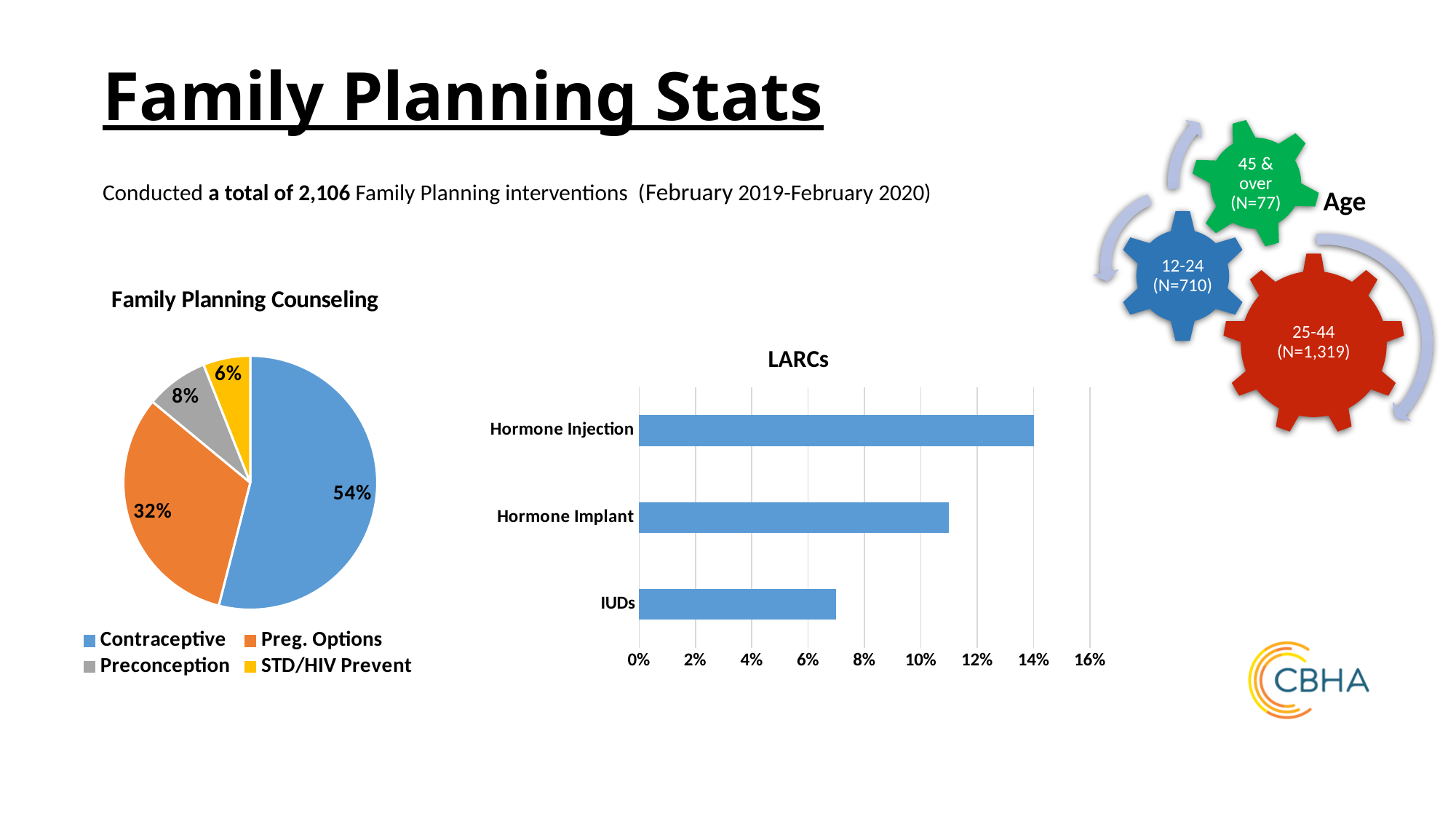
In the Family Planning Counseling pie chart, what share does Preg. Options have? 32% In the LARCs chart, is the value for IUDs greater or less than 8%? less In the Family Planning Counseling pie chart, what share does Contraceptive have? 54% In the Family Planning Counseling pie chart, what is the difference in percentage points between Contraceptive and Preg. Options? 22 In the LARCs chart, which category has the highest value? Hormone Injection In the Family Planning Counseling pie chart, which category has the smallest slice? STD/HIV Prevent In the LARCs chart, which category has the lowest value? IUDs In the Family Planning Counseling pie chart, which category has the largest slice? Contraceptive In the Family Planning Counseling pie chart, how many categories does the legend list? 4 In the Family Planning Counseling pie chart, what share does STD/HIV Prevent have? 6% In the LARCs chart, is the value for Hormone Implant greater or less than 10%? greater What kind of chart is the LARCs chart? Bar chart